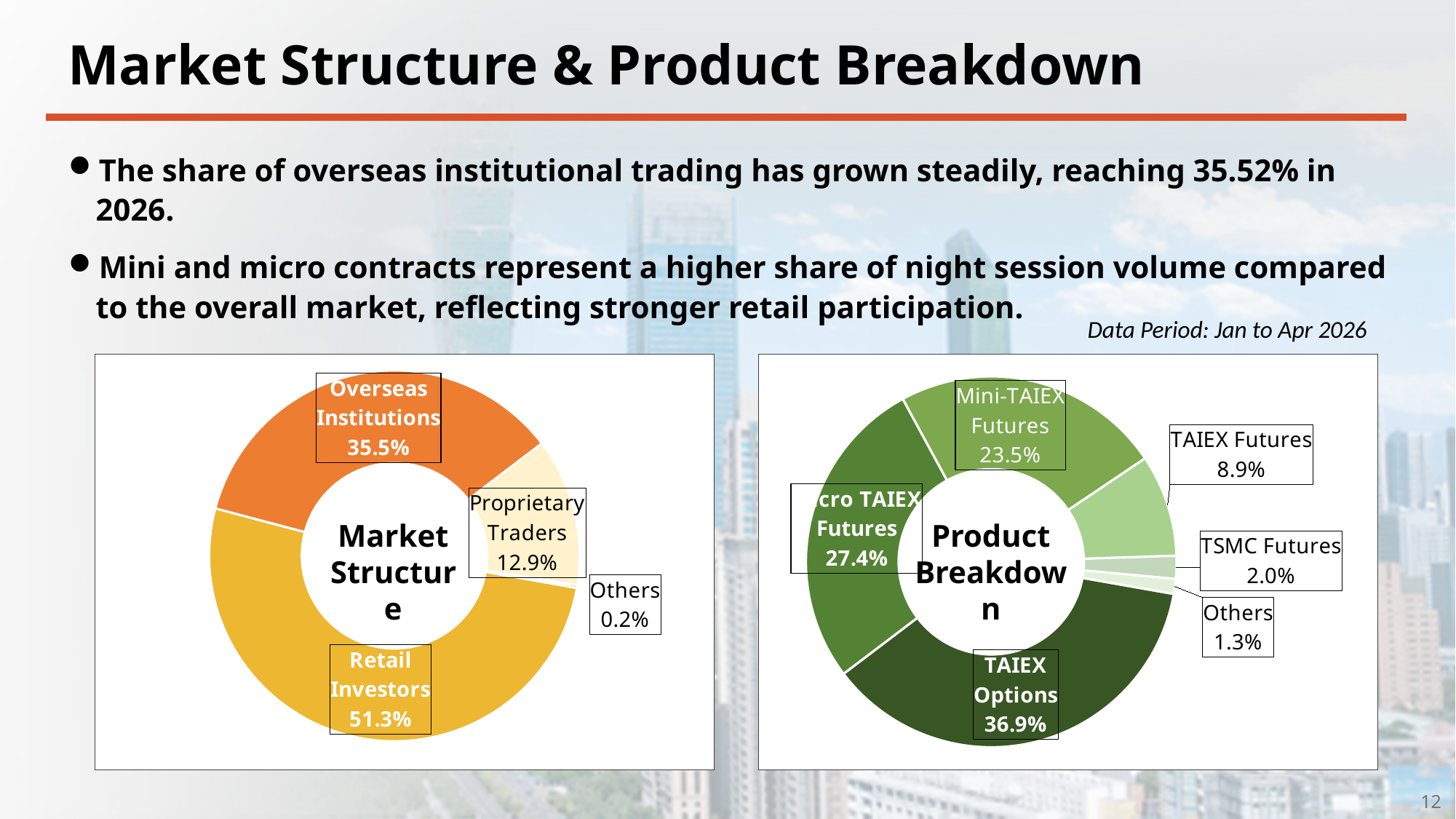
In the Product Breakdown chart, what share do Mini-TAIEX Futures hold? 23.5% In the Market Structure chart, what is the difference between the Retail Investors share and the Overseas Institutions share? 15.8% What type of chart is the Product Breakdown chart? Donut (pie) chart In the Product Breakdown chart, what is the difference between the TAIEX Futures share and the TSMC Futures share? 6.9% In the Market Structure chart, which category has the largest share? Retail Investors In the Product Breakdown chart, which is larger, TAIEX Futures or TSMC Futures? TAIEX Futures In the Product Breakdown chart, which product has the largest share? TAIEX Options In the Market Structure chart, what share do Overseas Institutions hold? 35.5% In the Market Structure chart, which category has the smallest share? Others In the Market Structure chart, how many categories are shown? 4 In the Product Breakdown chart, what share do TAIEX Options hold? 36.9% In the Market Structure chart, what share do Retail Investors hold? 51.3%